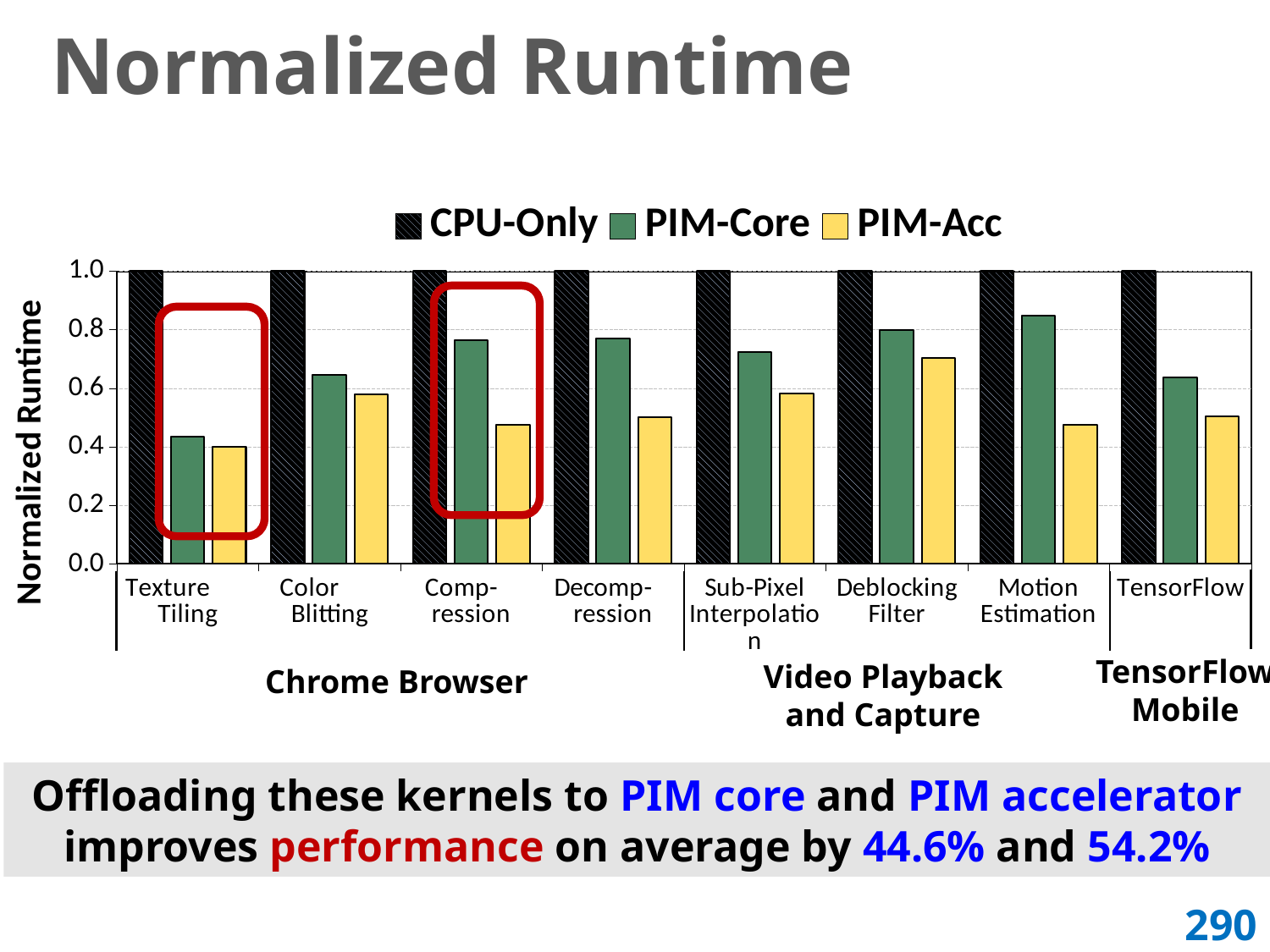
Is the PIM-Acc value for Deblocking Filter greater or less than 0.6? greater For Motion Estimation, which is larger, the PIM-Core value or the PIM-Acc value? PIM-Core What kind of chart is shown on the slide? bar chart Which is larger, the PIM-Acc value for Compression or the PIM-Acc value for Deblocking Filter? Deblocking Filter How many kernel categories are plotted along the x axis? 8 What is the title of the y axis? Normalized Runtime What is the CPU-Only normalized runtime for Texture Tiling? 1.0 Which category has the lowest PIM-Acc normalized runtime? Texture Tiling Is the PIM-Core value for Motion Estimation greater or less than 0.6? greater Is the PIM-Core value for Texture Tiling greater or less than 0.6? less How many series does the legend list? 3 Which category has the lowest PIM-Core normalized runtime? Texture Tiling